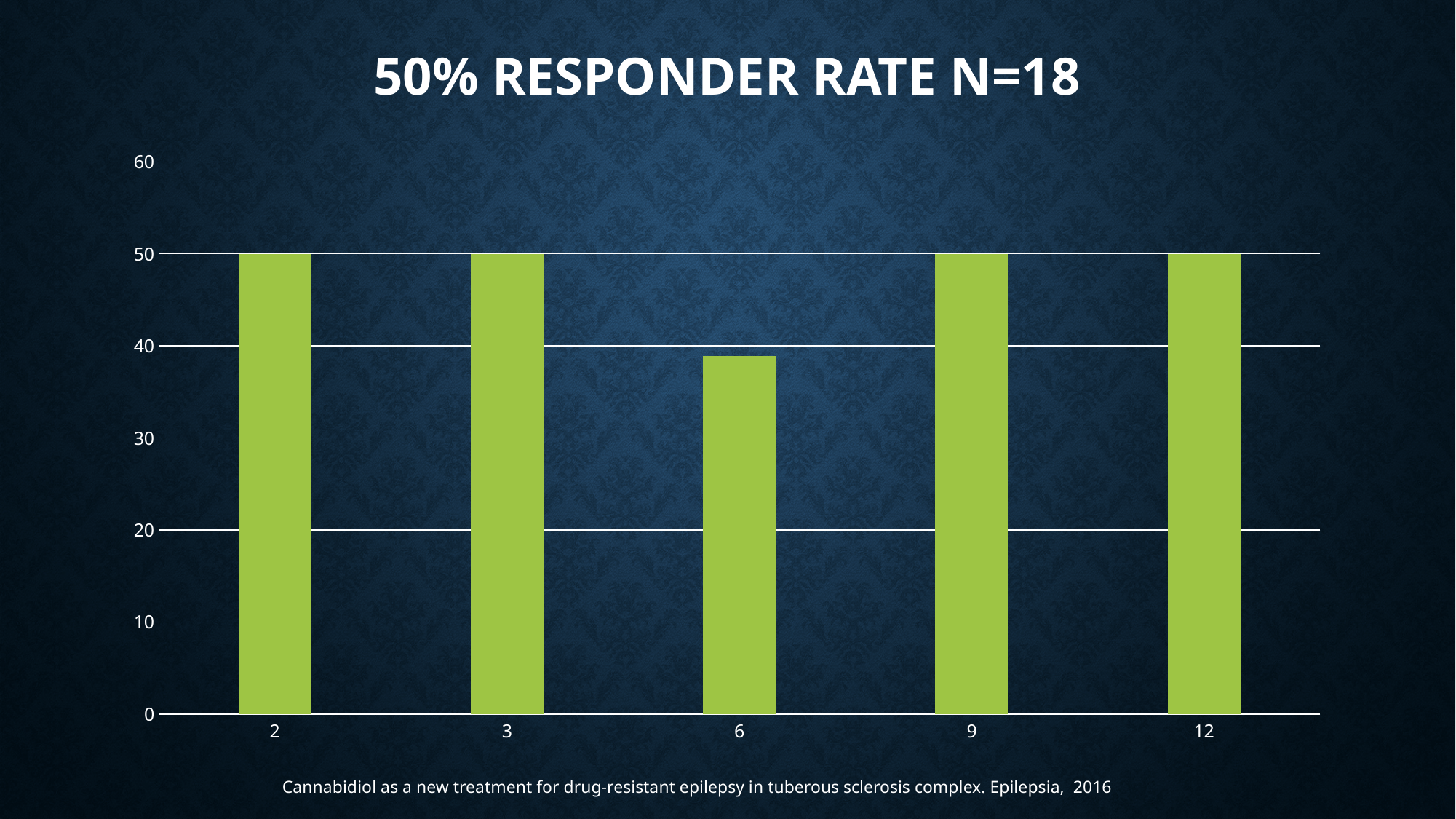
Which category has the lowest value? 6 How many categories are shown on the x axis? 5 What is the value for category 9? 50 What is the value for category 2? 50 Which is larger, the value for category 3 or the value for category 6? 3 Is the value for category 6 greater or less than 30? greater What is the title of the chart? 50% RESPONDER RATE N=18 What is the value for category 12? 50 What kind of chart is shown on the slide? bar chart What is the highest value shown on the y axis? 60 Is the value for category 6 greater or less than 40? less